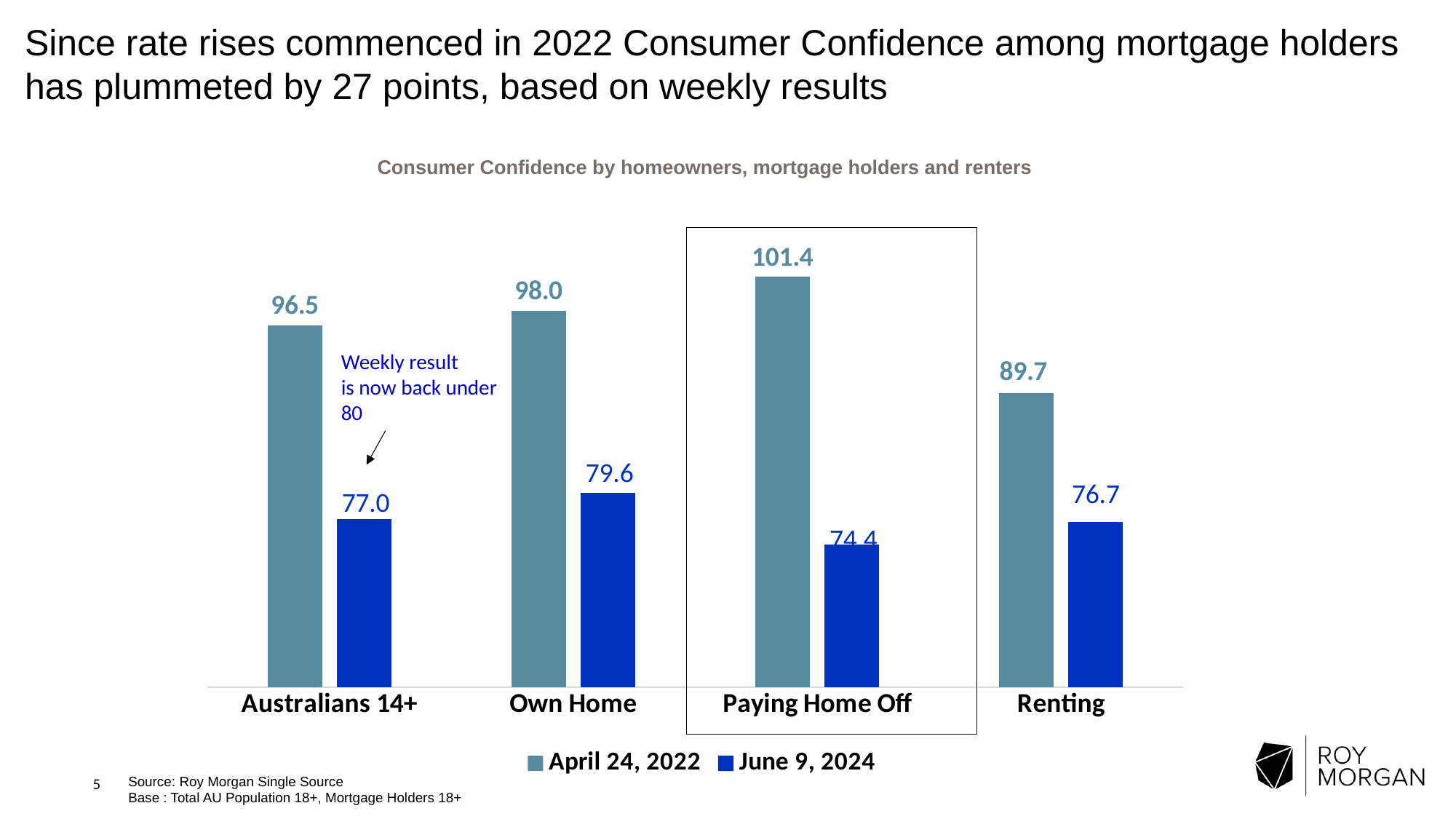
Which category has the highest value for April 24, 2022? Paying Home Off What is the Consumer Confidence value for Renting on June 9, 2024? 76.7 How many series does the legend list? 2 Which category has the lowest value for June 9, 2024? Paying Home Off What is the difference between the April 24, 2022 and June 9, 2024 values for Own Home? 18.4 By how much did Consumer Confidence for Paying Home Off fall from April 24, 2022 to June 9, 2024? 27.0 What kind of chart is shown on the slide? Bar chart How many categories are shown on the x axis? 4 Which is larger: the June 9, 2024 value for Own Home or for Renting? Own Home What is the title of the chart? Consumer Confidence by homeowners, mortgage holders and renters What is the Consumer Confidence value for Australians 14+ on June 9, 2024? 77.0 What is the Consumer Confidence value for Paying Home Off on April 24, 2022? 101.4